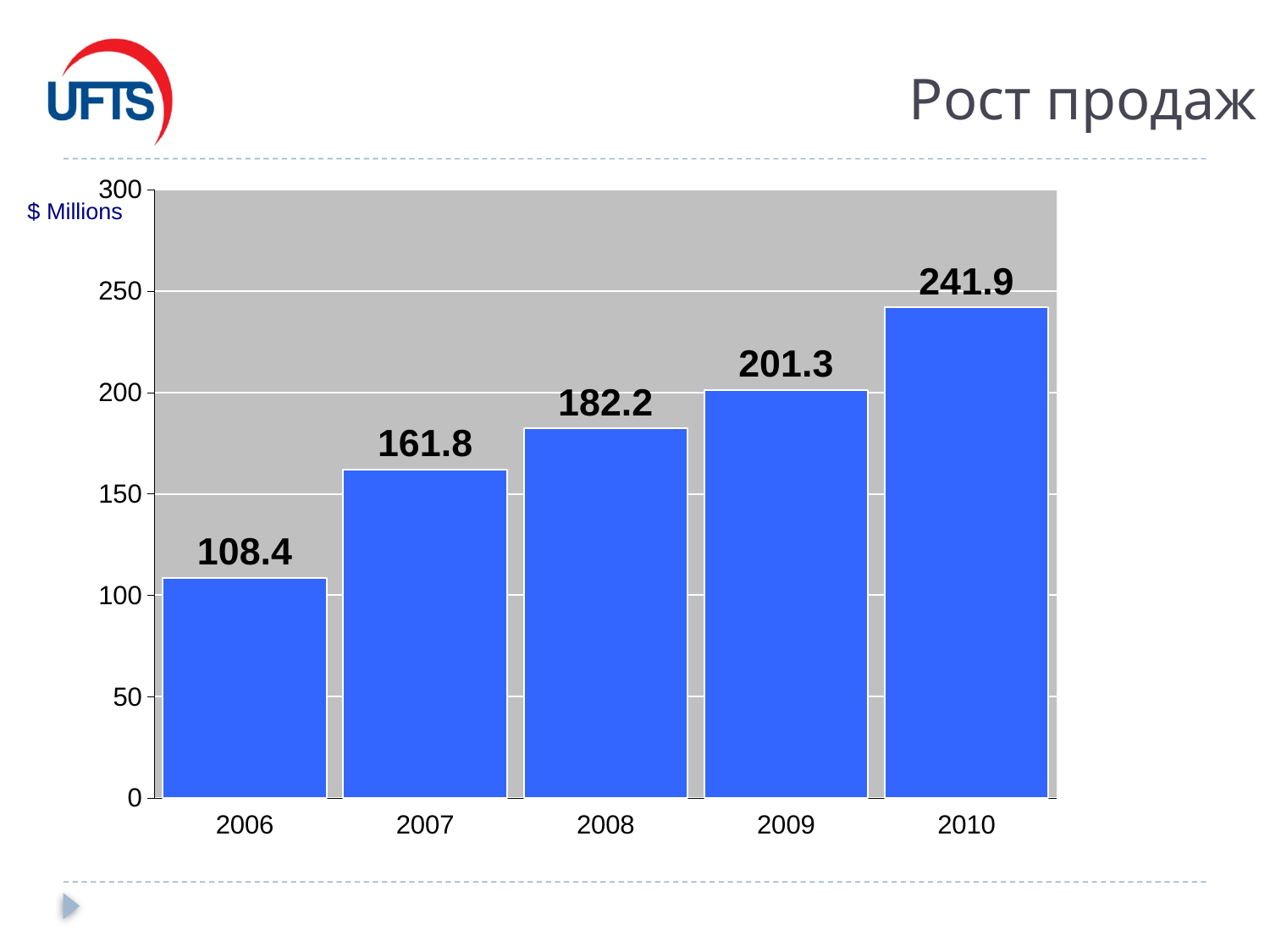
Which year has the highest value? 2010 What is the difference between the values for 2010 and 2009? 40.6 Do the values rise or fall from 2006 to 2010? rise Which is larger, the value for 2008 or the value for 2009? 2009 Which year has the lowest value? 2006 What is the difference between the values for 2007 and 2006? 53.4 What kind of chart is shown on the slide? bar chart How many years are shown on the x axis? 5 Is the value for 2009 greater or less than 200? greater What is the value for 2006? 108.4 What is the value for 2010? 241.9 What is the value for 2008? 182.2